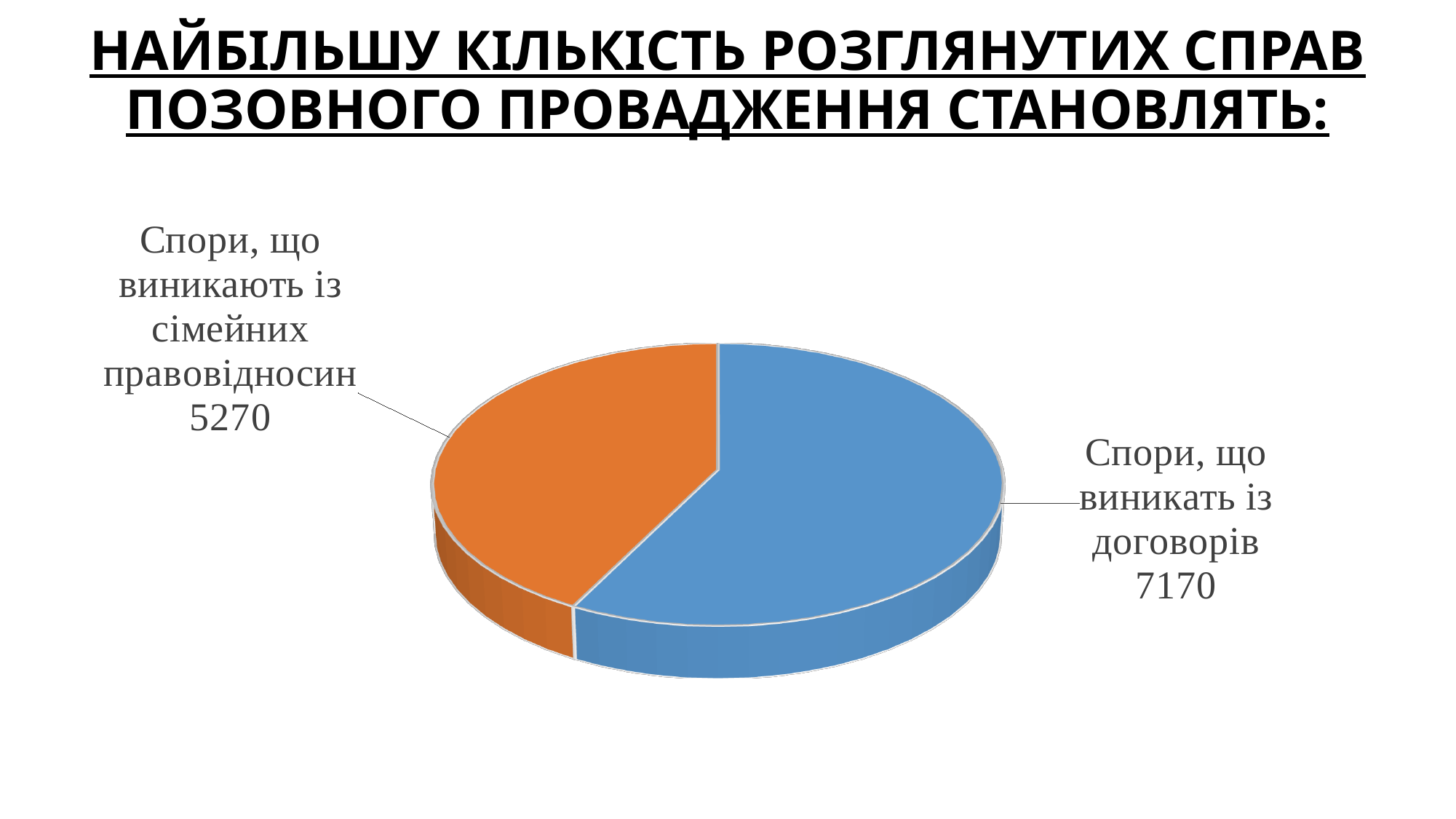
What colour is the slice for "Спори, що виникають із сімейних правовідносин"? orange Which category has the largest slice of the pie? Спори, що виникать із договорів What is the value for "Спори, що виникать із договорів"? 7170 What is the value for "Спори, що виникають із сімейних правовідносин"? 5270 What is the title of the slide above the pie chart? НАЙБІЛЬШУ КІЛЬКІСТЬ РОЗГЛЯНУТИХ СПРАВ ПОЗОВНОГО ПРОВАДЖЕННЯ СТАНОВЛЯТЬ: What is the total of the two values shown in the pie chart? 12440 What type of chart is shown on the slide? pie chart How many slices does the pie chart have? 2 What is the difference between the value for "Спори, що виникать із договорів" and the value for "Спори, що виникають із сімейних правовідносин"? 1900 Which is larger: the value for "Спори, що виникать із договорів" or the value for "Спори, що виникають із сімейних правовідносин"? Спори, що виникать із договорів Which category has the smallest slice of the pie? Спори, що виникають із сімейних правовідносин